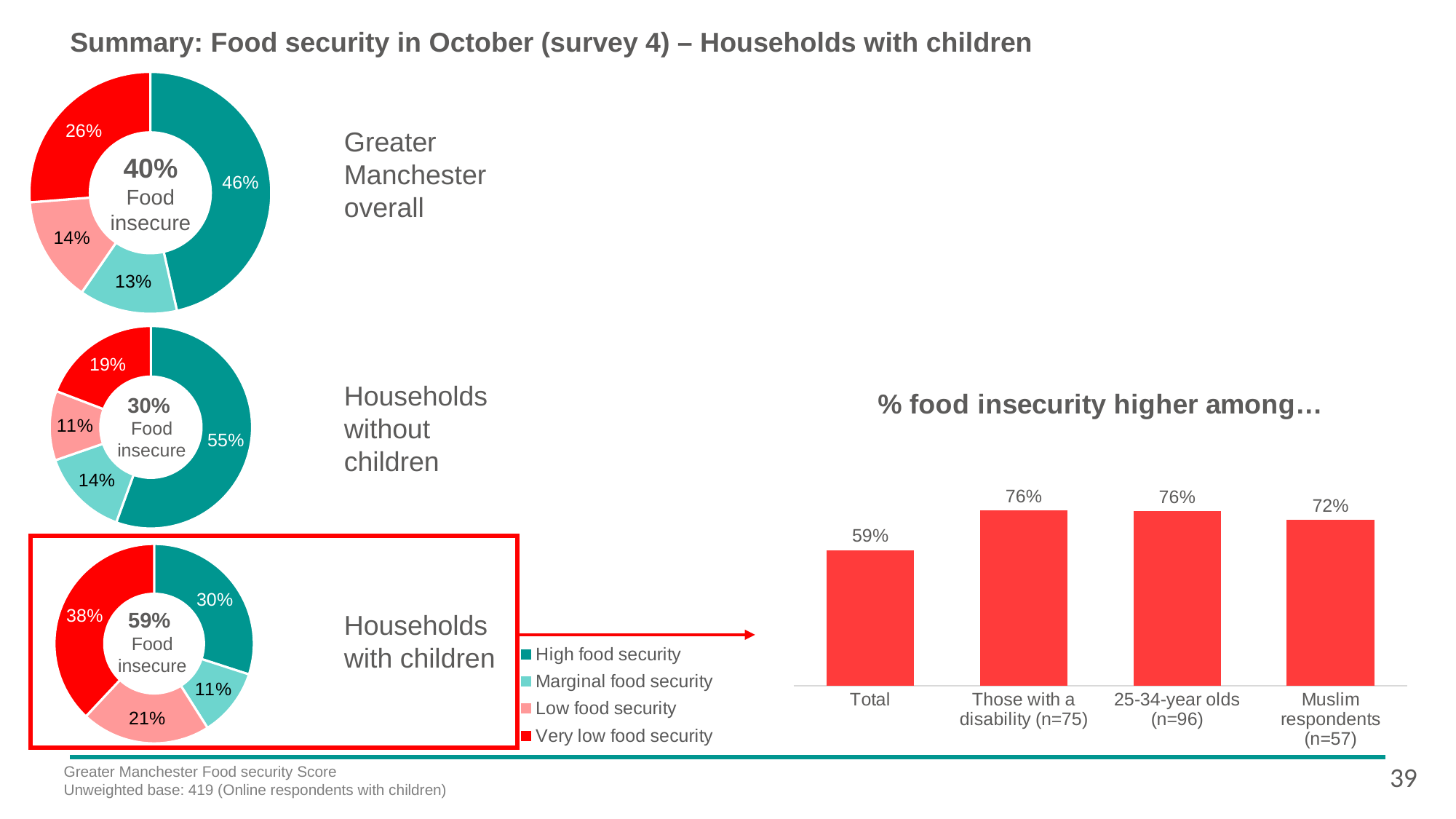
In the 'Greater Manchester overall' donut chart, what percentage is shown for High food security? 46% In the 'Households with children' donut chart, is the share for Very low food security larger or smaller than the share for High food security? Larger In the '% food insecurity higher among…' bar chart, what is the value for Muslim respondents (n=57)? 72% In the '% food insecurity higher among…' bar chart, how many categories are shown? 4 In the '% food insecurity higher among…' bar chart, what is the difference between the value for Those with a disability (n=75) and the value for Total? 17% In the 'Households with children' donut chart, what percentage is shown for Low food security? 21% How many entries does the legend for the donut charts list? 4 In the '% food insecurity higher among…' bar chart, which category has the lowest value? Total In the 'Greater Manchester overall' donut chart, which category has the smallest share? Marginal food security In the 'Households without children' donut chart, what percentage is shown for Very low food security? 19% In the 'Households with children' donut chart, which category has the largest share? Very low food security What kind of chart is the '% food insecurity higher among…' chart? Bar chart